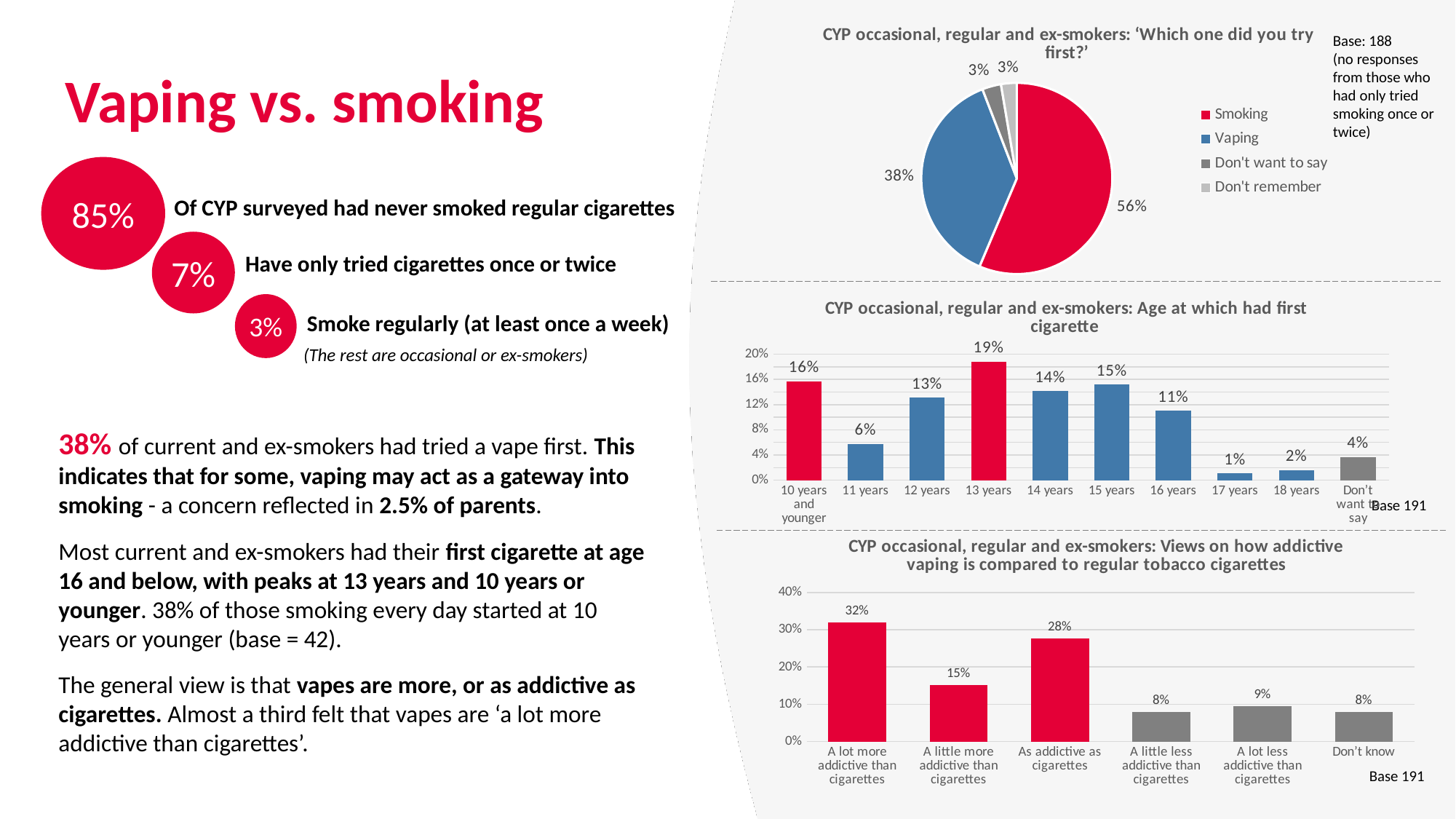
In the pie chart 'Which one did you try first?', what share of respondents said Vaping? 38% In the 'Views on how addictive vaping is' chart, what is the difference between 'A lot more addictive than cigarettes' and 'As addictive as cigarettes'? 4% In the 'Age at which had first cigarette' chart, which is larger: the value for 14 years or the value for 16 years? 14 years In the 'Views on how addictive vaping is' chart, what is the value for 'A lot more addictive than cigarettes'? 32% How many entries does the legend of the pie chart 'Which one did you try first?' list? 4 In the 'Age at which had first cigarette' chart, which age category has the lowest value? 17 years In the 'Age at which had first cigarette' chart, which age category has the highest value? 13 years In the 'Age at which had first cigarette' chart, what is the value for 11 years? 6% In the pie chart 'Which one did you try first?', what share of respondents said Smoking? 56% What type of chart is the 'Views on how addictive vaping is compared to regular tobacco cigarettes' chart? Bar chart In the 'Age at which had first cigarette' chart, how many categories are shown on the x axis? 10 In the pie chart 'Which one did you try first?', what is the difference between the Smoking and Vaping shares? 18%